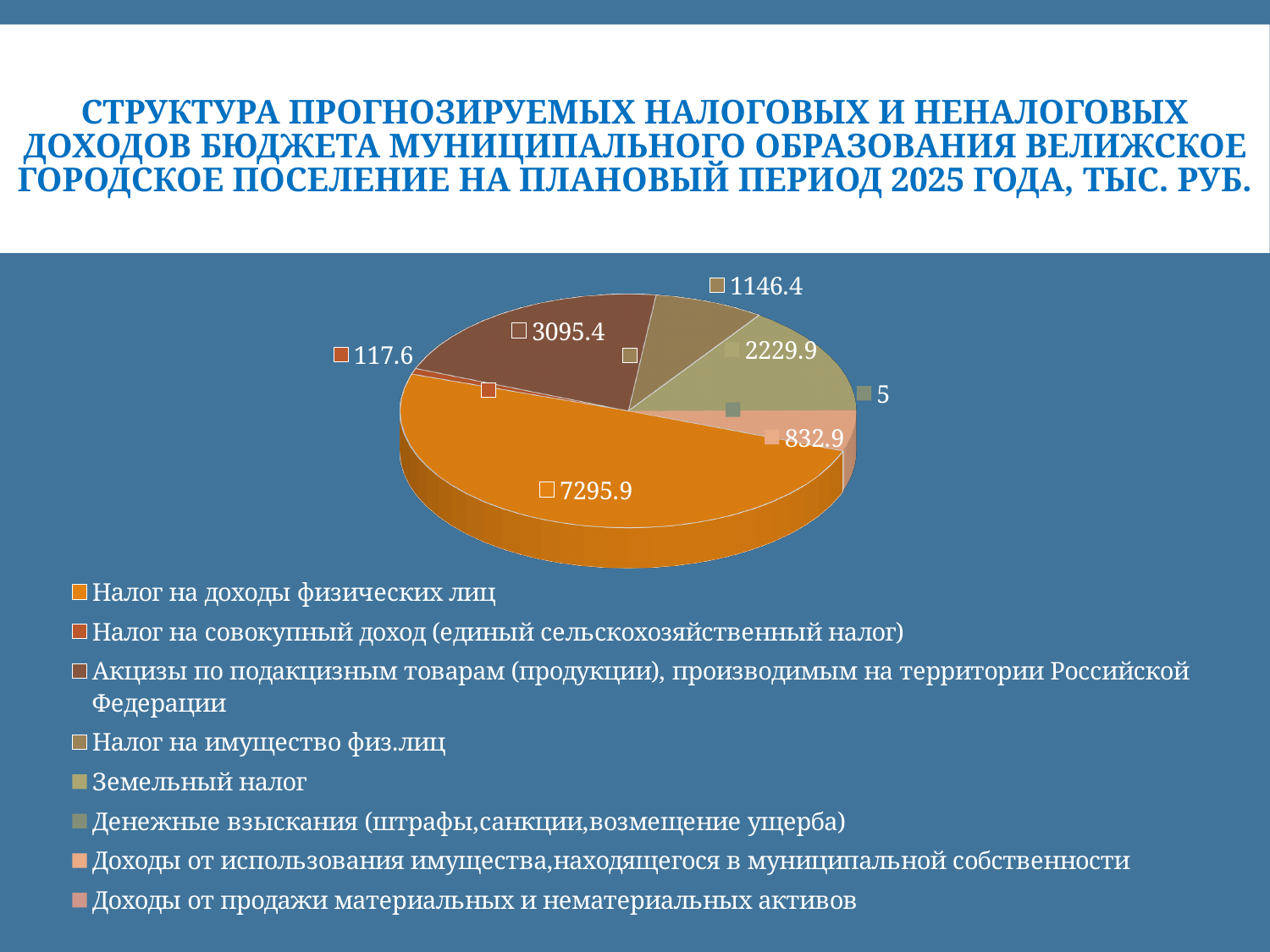
Which is larger: the value for Акцизы по подакцизным товарам or the value for Земельный налог? Акцизы по подакцизным товарам What is the value shown for Денежные взыскания (штрафы,санкции,возмещение ущерба)? 5 What is the value shown for Земельный налог? 2229.9 Which category has the largest slice of the pie? Налог на доходы физических лиц What type of chart is shown on the slide? pie chart Which is larger: the value for Налог на имущество физ.лиц or the value for Земельный налог? Земельный налог What is the difference between the values for Налог на доходы физических лиц and Акцизы по подакцизным товарам? 4200.5 In what units are the values on the chart expressed, according to the slide title? тыс. руб. What is the value shown for Акцизы по подакцизным товарам (продукции), производимым на территории Российской Федерации? 3095.4 How many categories does the legend list? 8 What is the value shown for Налог на совокупный доход (единый сельскохозяйственный налог)? 117.6 What is the value shown for Налог на доходы физических лиц? 7295.9